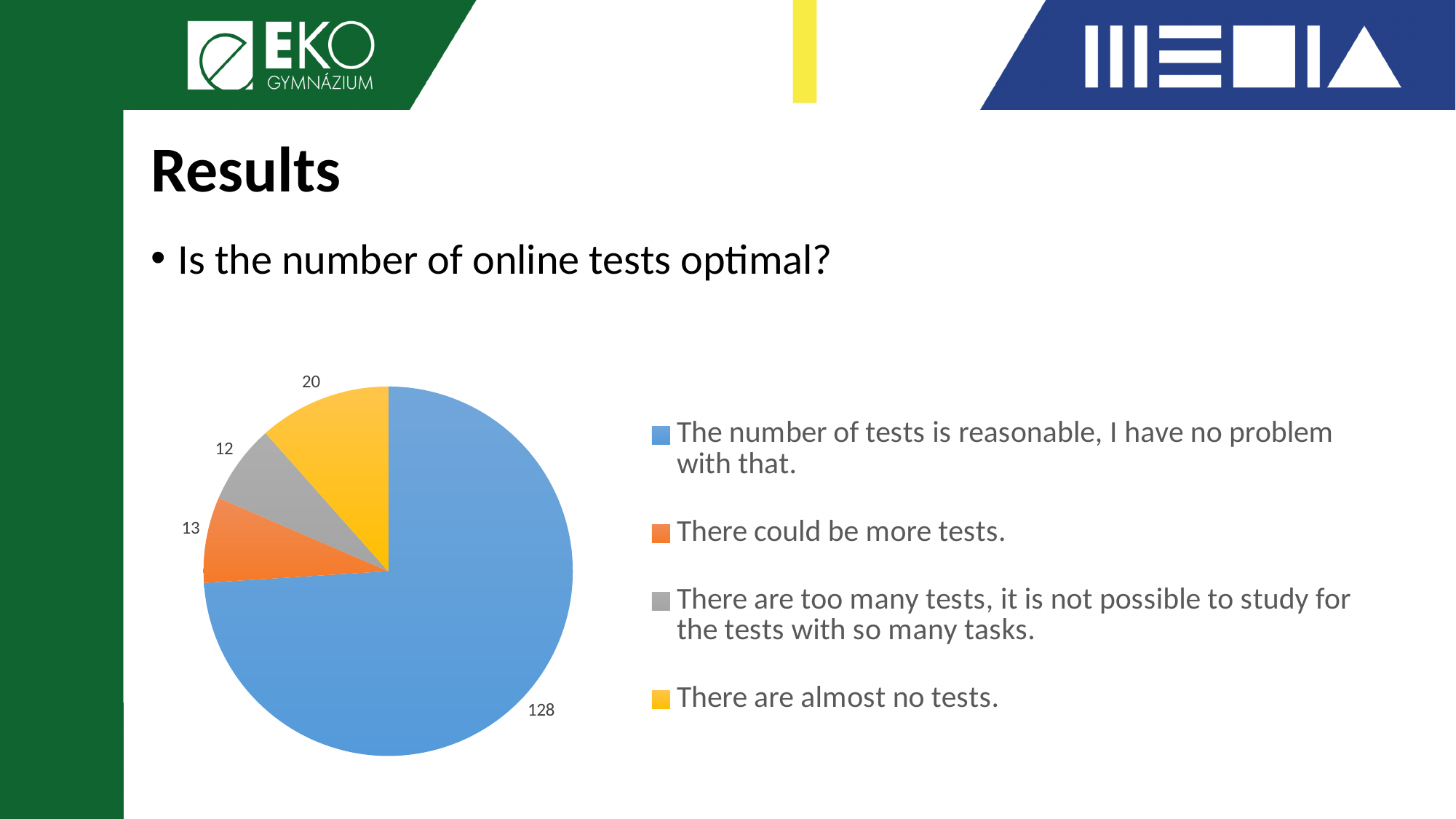
Which response has the smallest slice of the pie? There are too many tests, it is not possible to study for the tests with so many tasks. What is the difference between the value for "There are almost no tests." and the value for "There could be more tests."? 7 Which response has the largest slice of the pie? The number of tests is reasonable, I have no problem with that. What is the value for "There are too many tests, it is not possible to study for the tests with so many tasks."? 12 What is the total of all the values in the pie chart? 173 What is the value for "There are almost no tests."? 20 Which colour represents "There are almost no tests." in the pie chart? yellow What is the value for "There could be more tests."? 13 What is the value for "The number of tests is reasonable, I have no problem with that."? 128 How many slices does the pie chart have? 4 Which is larger: the value for "There are almost no tests." or the value for "There could be more tests."? There are almost no tests. What kind of chart is shown on the slide? pie chart